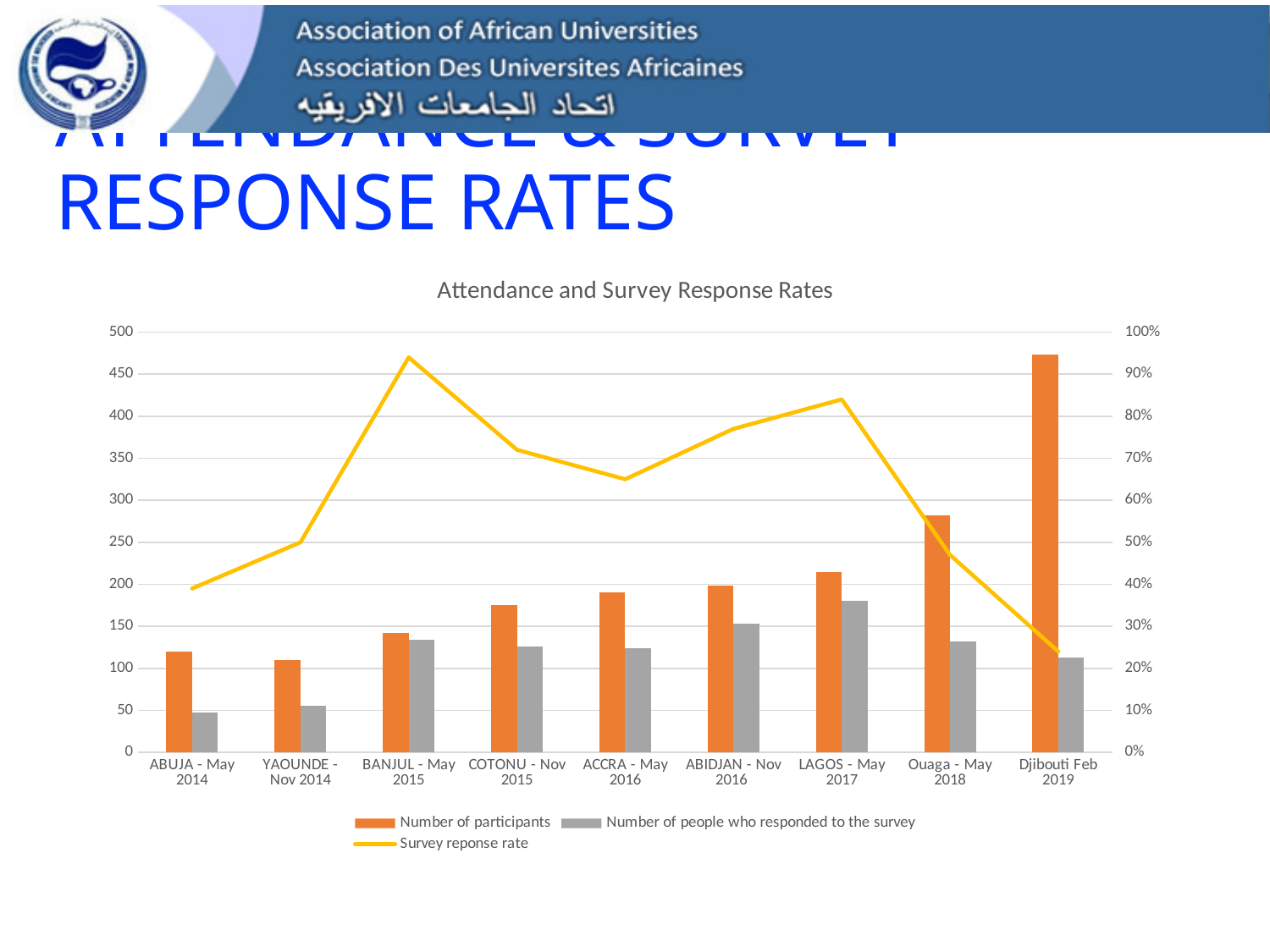
Is the survey response rate for Djibouti Feb 2019 greater or less than 30%? less Which event has the lowest survey response rate? Djibouti Feb 2019 Which event has the highest number of people who responded to the survey? LAGOS - May 2017 What kind of chart is this? Combined bar and line chart Which has more participants, LAGOS - May 2017 or Ouaga - May 2018? Ouaga - May 2018 How many categories (events) are shown on the x axis? 9 Which event has the highest survey response rate? BANJUL - May 2015 Which colour represents the Survey reponse rate series? Yellow Is the number of participants for Djibouti Feb 2019 greater or less than 450? greater Which event has the highest number of participants? Djibouti Feb 2019 What is the title of the chart? Attendance and Survey Response Rates How many series does the chart legend list? 3